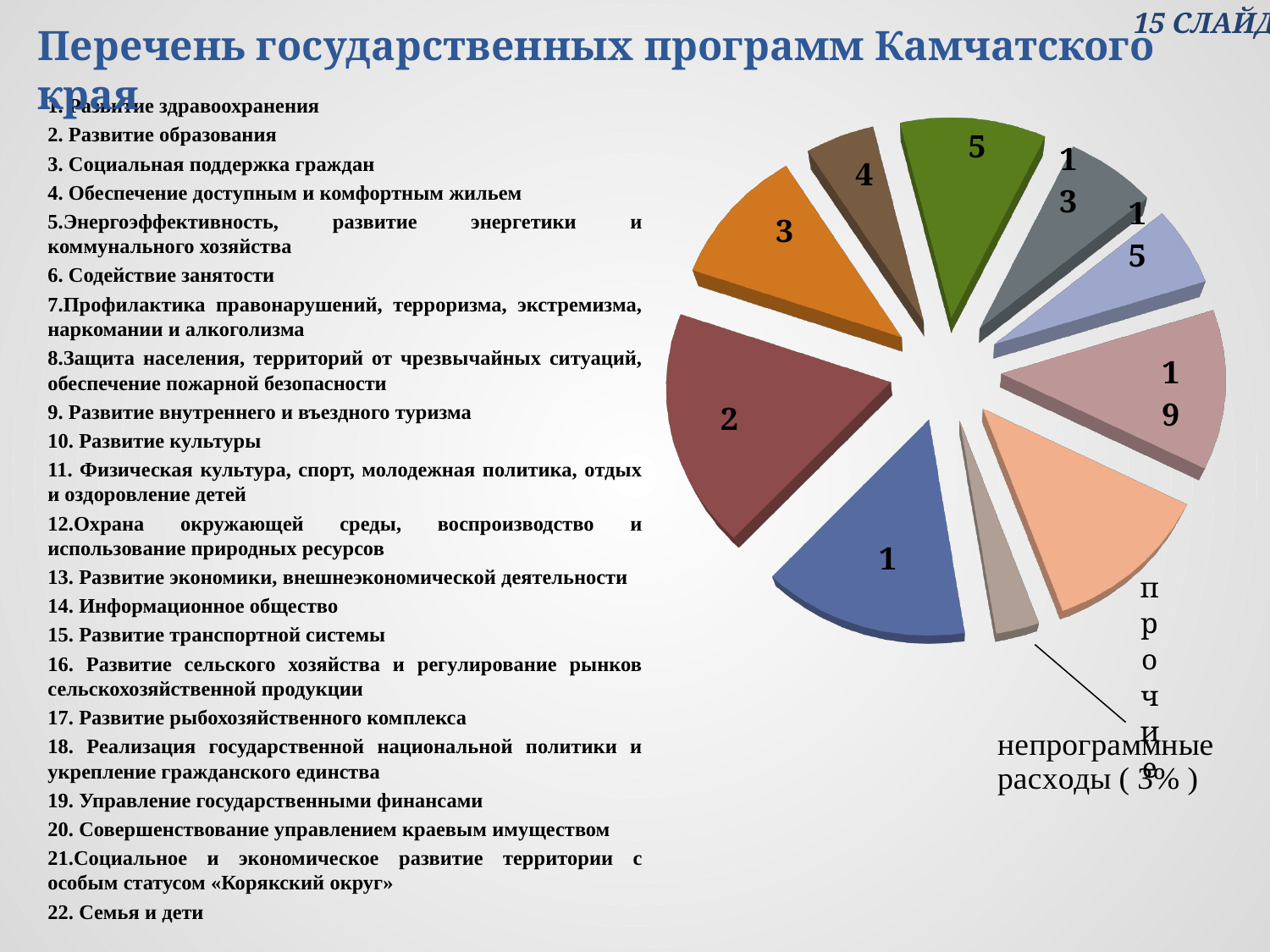
How many slices does the pie chart have? 10 What is the title of the slide containing the pie chart? Перечень государственных программ Камчатского края Which slice of the pie chart is the largest? the slice labelled 2 Which slice is larger, the one labelled 2 or the one labelled 19? 2 Which slice of the pie chart is the smallest? непрограммные расходы What kind of chart is shown on the slide? pie chart What colour is the largest slice of the pie chart (labelled 2)? dark red Which slice is larger, the one labelled 3 or the one labelled 4? 3 Which slice is larger, the one labelled 1 or the one labelled 13? 1 What share of the pie is labelled as непрограммные расходы? 3%